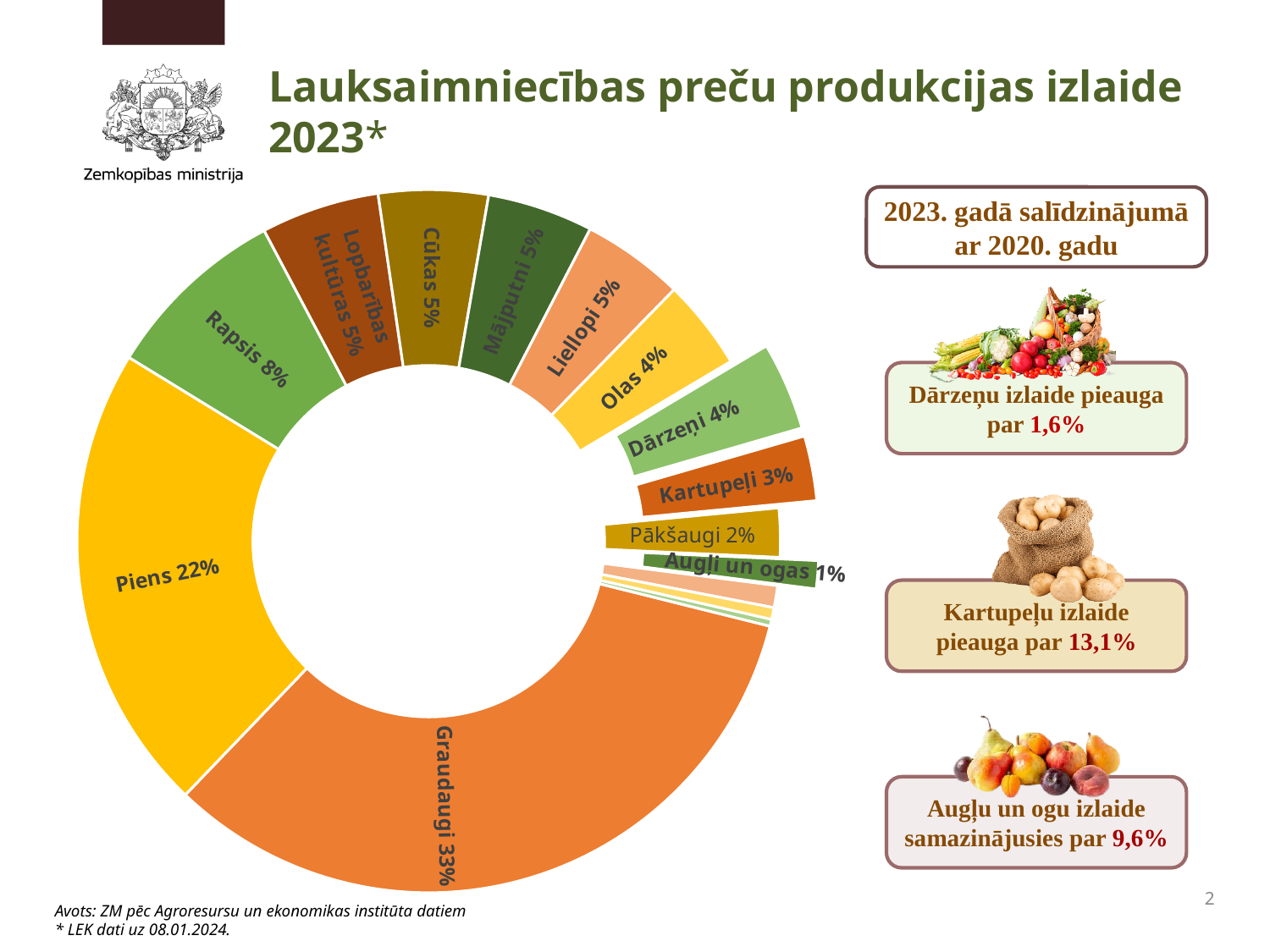
What is the title of the slide containing the chart? Lauksaimniecības preču produkcijas izlaide 2023* What is the difference in percentage points between Graudaugi and Piens? 11 Which labelled category has the smallest share of the chart? Augļi un ogas What percentage is shown for Rapsis? 8% Which is larger, the share for Rapsis or the share for Olas? Rapsis What is the combined share of Dārzeņi and Kartupeļi? 7% What is the value shown for Piens? 22% What percentage is shown for Pākšaugi? 2% What share of the chart does Graudaugi account for? 33% Which category has the largest share of the chart? Graudaugi What kind of chart is shown on the slide? Doughnut (pie) chart What is the value shown for Kartupeļi? 3%